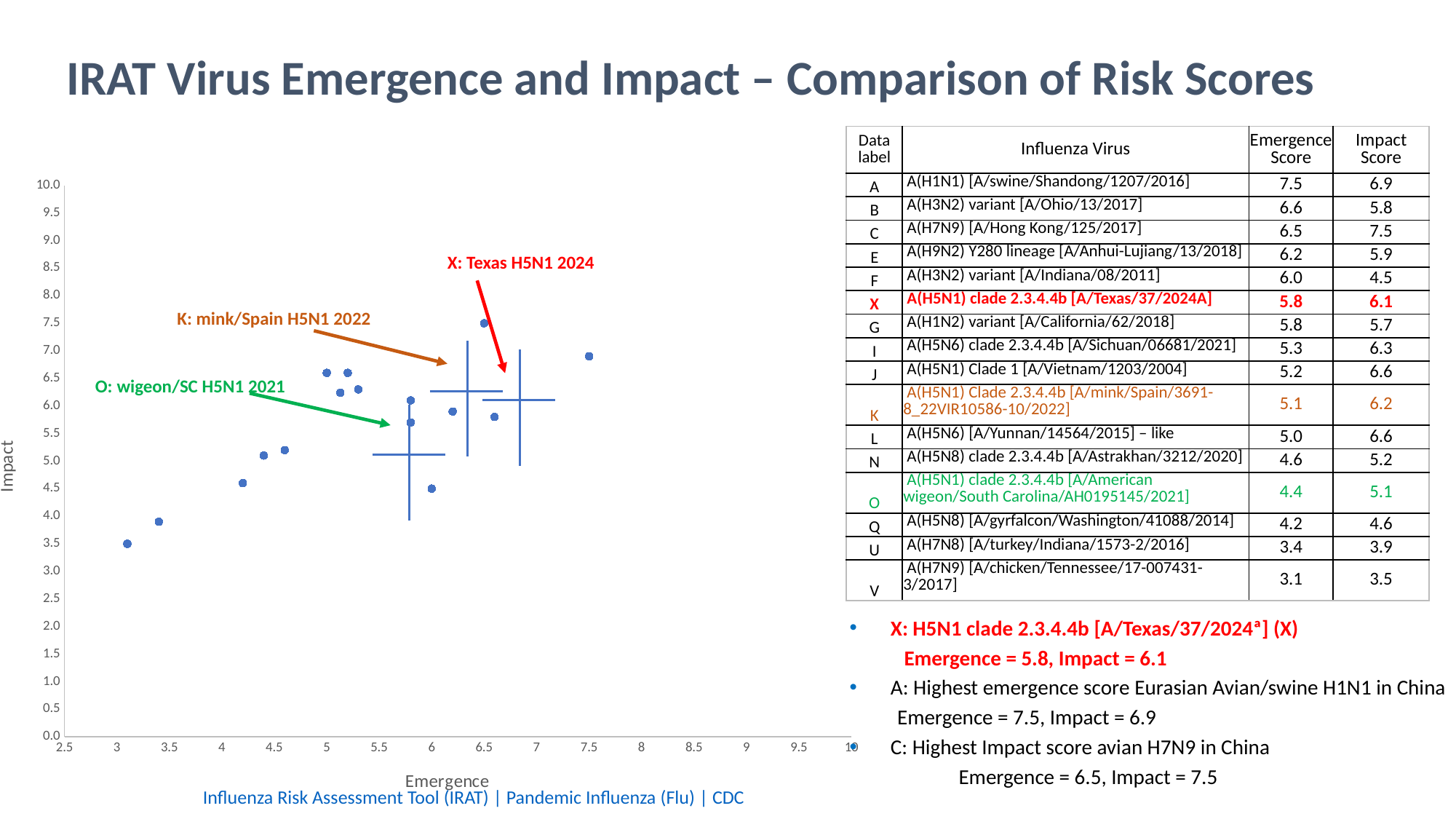
Do the Impact values generally rise or fall as Emergence increases along the x axis? rise Which data label has the highest Impact Score? C What is the Emergence Score of virus X (A(H5N1) clade 2.3.4.4b [A/Texas/37/2024A])? 5.8 How many data points are plotted on the chart? 16 What is the title of the vertical axis of the chart? Impact Which has the higher Impact Score, K (mink/Spain H5N1 2022) or O (wigeon/SC H5N1 2021)? K Which data label has the highest Emergence Score? A What is the difference between the Emergence Score of A and the Emergence Score of X? 1.7 What is the Impact Score of virus X (A(H5N1) clade 2.3.4.4b [A/Texas/37/2024A])? 6.1 What kind of chart is shown on the slide? scatter chart Which data label has the lowest Emergence Score? V What is the title of the horizontal axis of the chart? Emergence